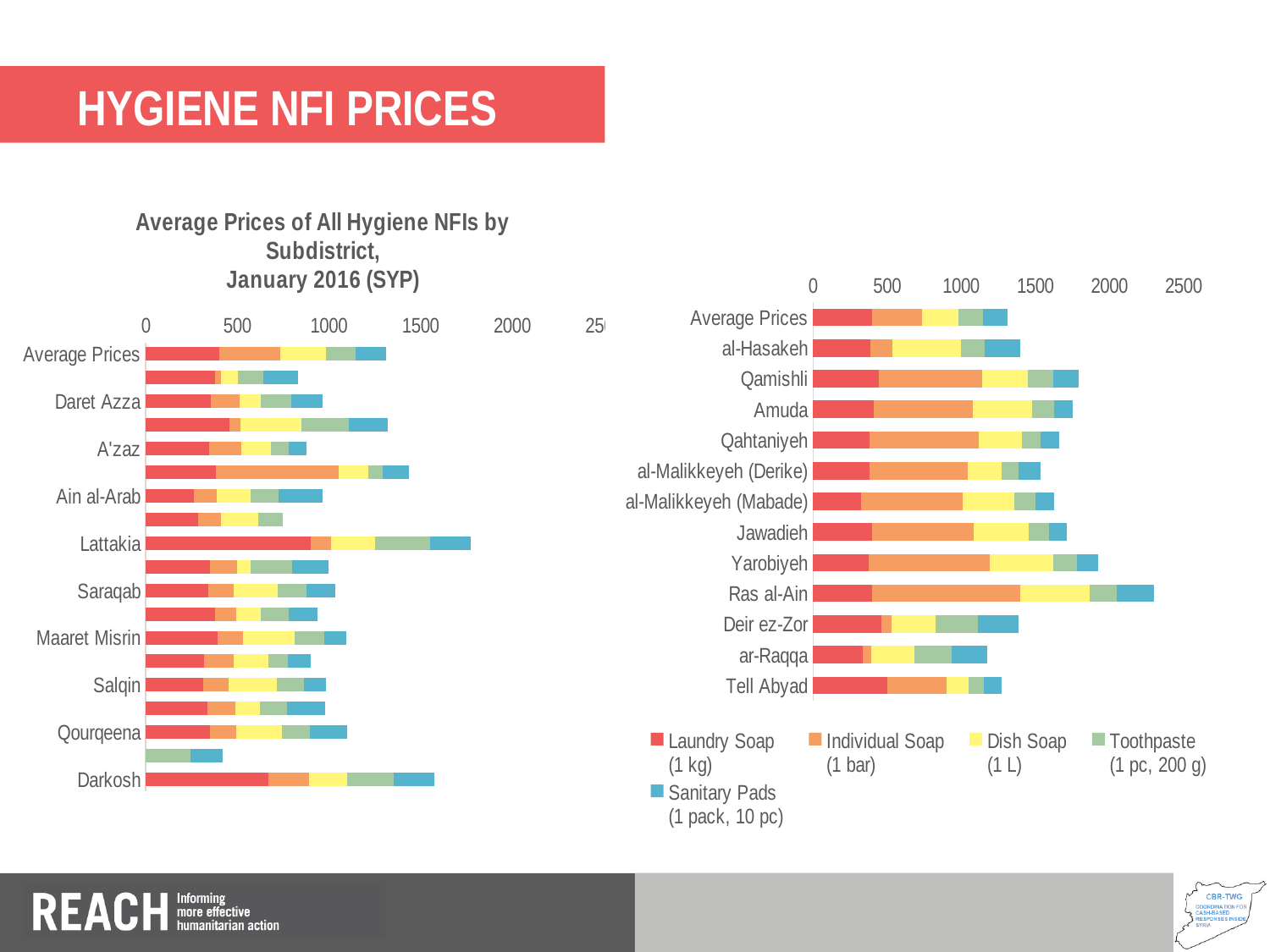
Which series in the legend is shown in yellow? Dish Soap (1 L) How many series does the legend on the slide list? 5 What kind of chart is the chart on the right side of the slide? bar chart In the chart titled 'Average Prices of All Hygiene NFIs by Subdistrict, January 2016 (SYP)', is the total for Lattakia greater or less than 1500? greater In the right-hand chart, how many subdistrict categories (including Average Prices) are plotted? 13 In the chart titled 'Average Prices of All Hygiene NFIs by Subdistrict, January 2016 (SYP)', which labelled subdistrict has the highest total bar? Lattakia In the right-hand chart, is the total for Qamishli greater or less than 1500? greater In the right-hand chart, which has the larger total bar, Ras al-Ain or Yarobiyeh? Ras al-Ain In the right-hand chart, is the total for al-Hasakeh greater or less than 1500? less In the right-hand chart, which category has the highest total bar? Ras al-Ain In the chart titled 'Average Prices of All Hygiene NFIs by Subdistrict, January 2016 (SYP)', which has the larger total bar, Saraqab or A'zaz? Saraqab